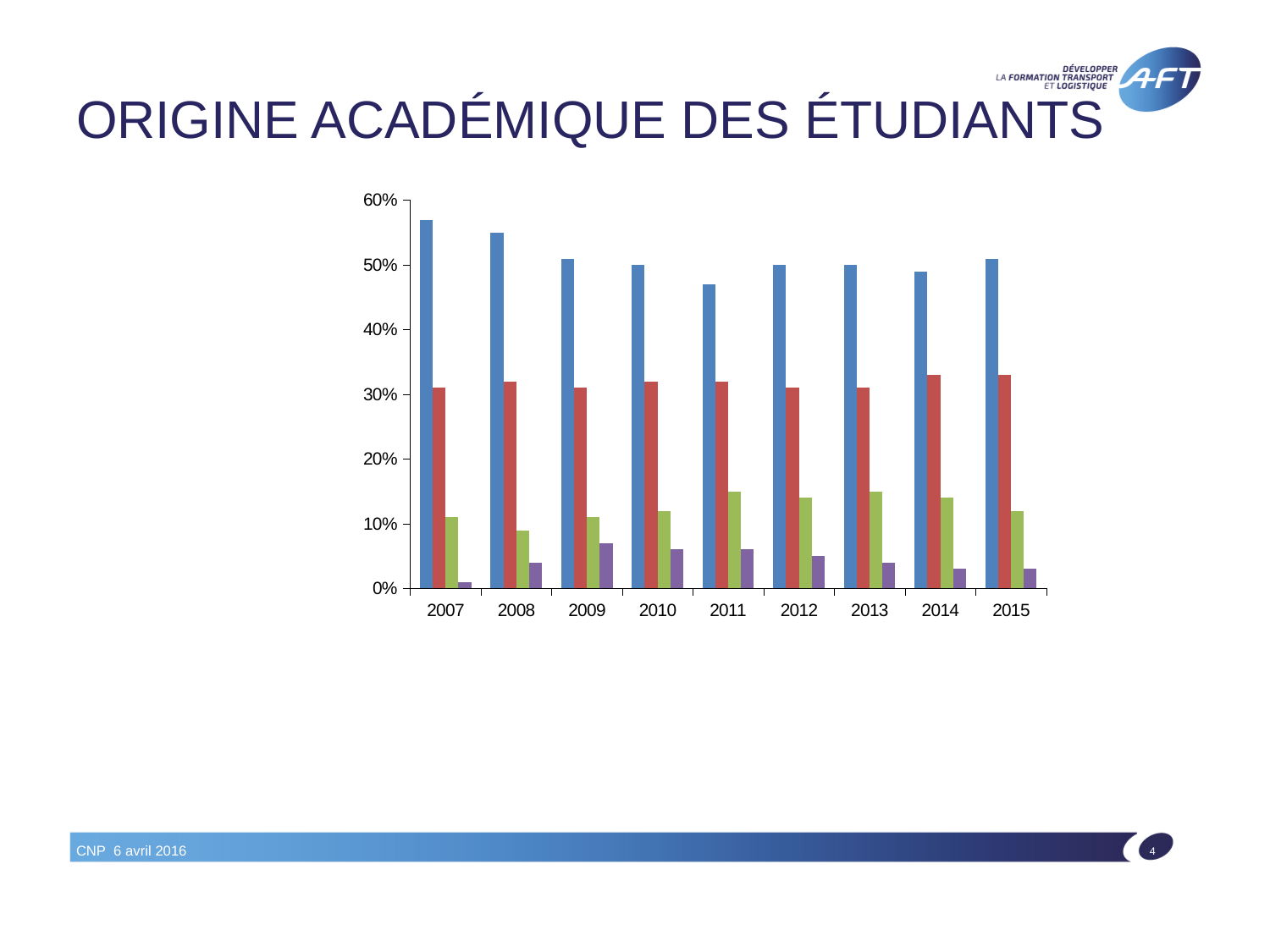
Does the blue series rise or fall from 2007 to 2011? fall Is the value of the green bar for 2011 greater or less than 10%? greater Is the value of the purple bar for 2009 greater or less than 10%? less Is the value of the blue bar for 2011 greater or less than 50%? less In which year is the purple bar the shortest? 2007 What is the title of the slide containing the chart? ORIGINE ACADÉMIQUE DES ÉTUDIANTS In which year is the blue bar the tallest? 2007 How many years are shown on the x axis of the chart? 9 What kind of chart is shown on the slide? bar chart How many bars are plotted for each year in the chart? 4 In 2007, which is larger: the blue bar or the red bar? the blue bar